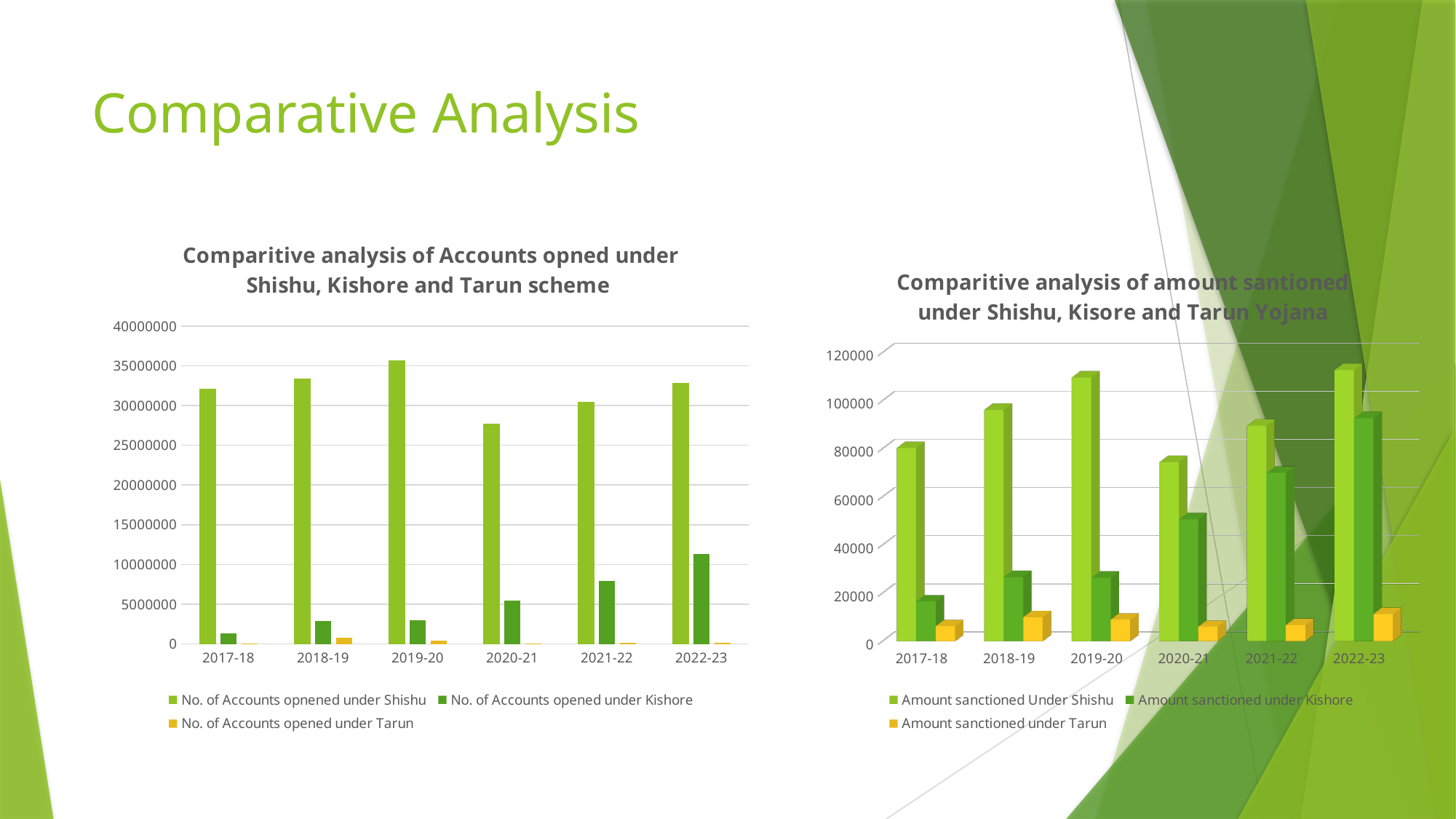
In the right chart (amount sanctioned under Shishu, Kisore and Tarun Yojana), which year has the highest amount sanctioned under Kishore? 2022-23 In the right chart (amount sanctioned under Shishu, Kisore and Tarun Yojana), which is larger in 2021-22: the amount sanctioned under Shishu or under Kishore? Amount sanctioned Under Shishu In the right chart (amount sanctioned under Shishu, Kisore and Tarun Yojana), is the amount sanctioned under Shishu in 2019-20 greater or less than 100000? greater In the left chart (Accounts opened under Shishu, Kishore and Tarun scheme), how many series does the legend list? 3 In the left chart (Accounts opened under Shishu, Kishore and Tarun scheme), which year has the highest number of accounts opened under Kishore? 2022-23 In the left chart (Accounts opened under Shishu, Kishore and Tarun scheme), which year has the highest number of accounts opened under Shishu? 2019-20 In the right chart (amount sanctioned under Shishu, Kisore and Tarun Yojana), which year has the lowest amount sanctioned under Shishu? 2020-21 In the left chart (Accounts opened under Shishu, Kishore and Tarun scheme), is the number of accounts opened under Shishu in 2019-20 greater or less than 35000000? greater What kind of chart is the right chart (amount sanctioned under Shishu, Kisore and Tarun Yojana)? bar chart In the left chart (Accounts opened under Shishu, Kishore and Tarun scheme), which year has the lowest number of accounts opened under Shishu? 2020-21 In the left chart (Accounts opened under Shishu, Kishore and Tarun scheme), do the number of accounts opened under Kishore rise or fall from 2017-18 to 2022-23? rise In the left chart (Accounts opened under Shishu, Kishore and Tarun scheme), is the number of accounts opened under Kishore in 2022-23 greater or less than 10000000? greater